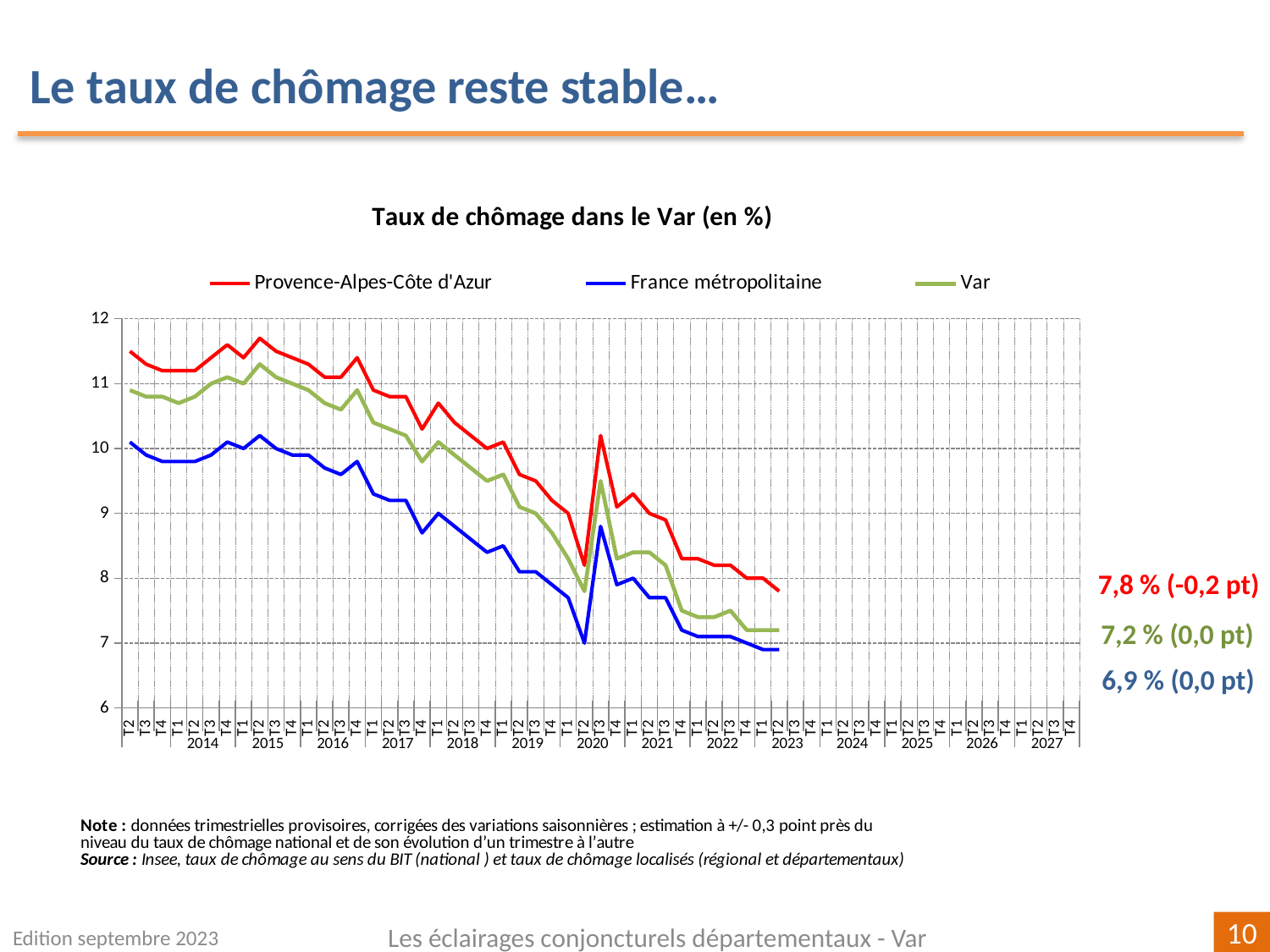
Is the value for France métropolitaine in T2 2020 greater or less than 8? less What is the latest unemployment rate shown for France métropolitaine? 6,9 % What is the latest unemployment rate shown for Provence-Alpes-Côte d'Azur? 7,8 % What is the quarterly change indicated for Provence-Alpes-Côte d'Azur's latest value? -0,2 pt Overall, do the unemployment rates rise or fall from 2014 to 2023? fall Which series has the highest values across the whole period? Provence-Alpes-Côte d'Azur What is the title of the chart? Taux de chômage dans le Var (en %) Which series has the lowest values across the whole period? France métropolitaine What is the difference between the latest values for Provence-Alpes-Côte d'Azur and France métropolitaine? 0,9 pt What is the latest unemployment rate shown for Var? 7,2 % What type of chart is shown on the slide? line chart How many series does the legend list? 3